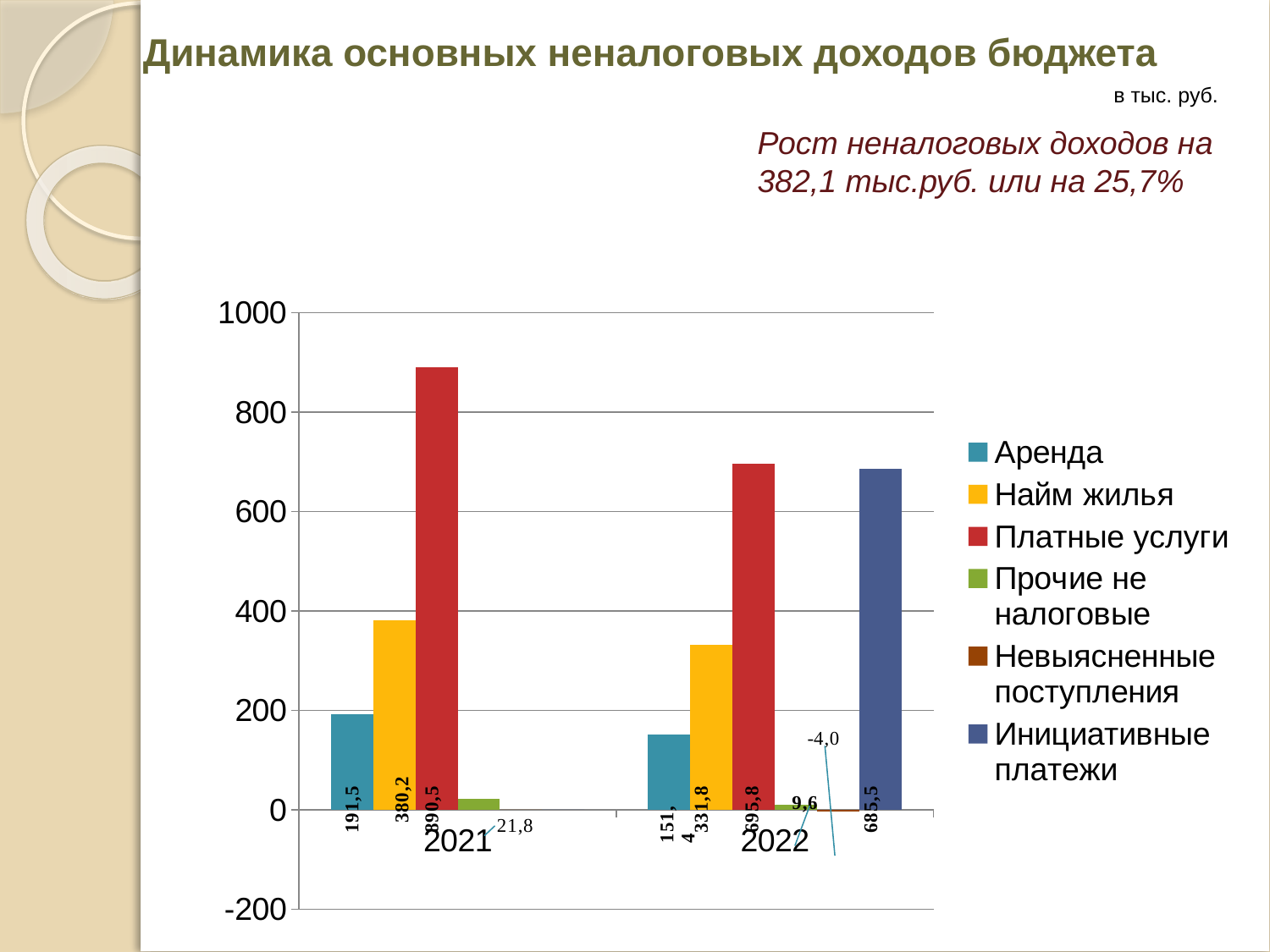
Is the value for Аренда larger in 2021 or in 2022? 2021 What kind of chart is shown on the slide? bar chart What is the difference between the Платные услуги values for 2021 and 2022? 194,7 What is the value for Найм жилья in 2022? 331,8 What is the value for Платные услуги in 2021? 890,5 Which series has the highest value in 2021? Платные услуги Does the value for Аренда rise or fall from 2021 to 2022? fall What is the value for Инициативные платежи in 2022? 685,5 Is the value for Найм жилья in 2021 greater or less than 400? less How many series does the legend list? 6 Which series has the lowest value in 2022? Невыясненные поступления What is the value for Невыясненные поступления in 2022? -4,0